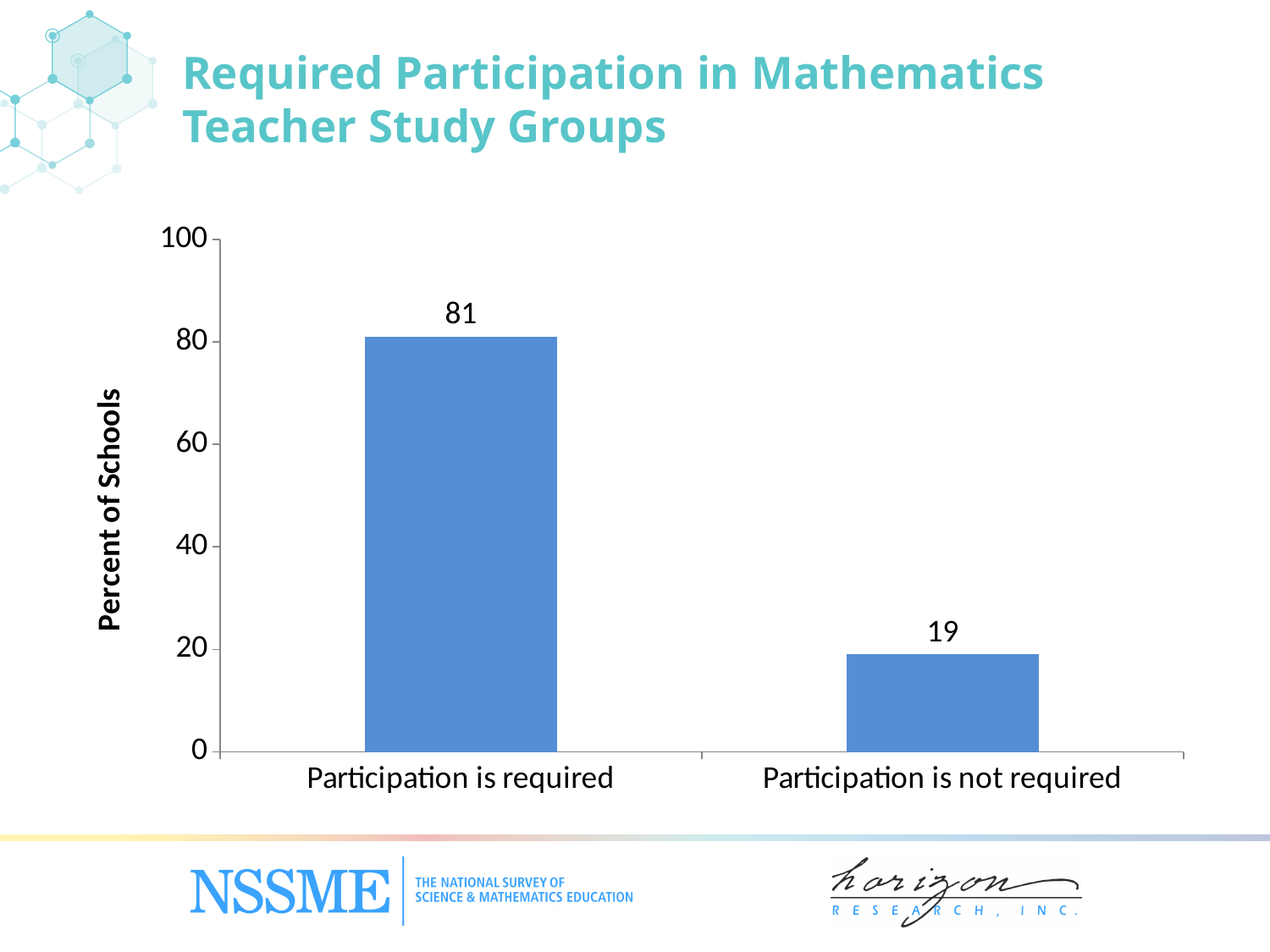
What is the title of the slide? Required Participation in Mathematics Teacher Study Groups What is the difference in percent of schools between 'Participation is required' and 'Participation is not required'? 62 What percent of schools have participation not required in mathematics teacher study groups? 19 What percent of schools have participation required in mathematics teacher study groups? 81 Is the value for 'Participation is required' larger or smaller than the value for 'Participation is not required'? larger How many categories are shown on the x axis? 2 What is the label of the vertical axis? Percent of Schools Which category has the higher percent of schools? Participation is required Which category has the lower percent of schools? Participation is not required What kind of chart is shown on the slide? bar chart Is the value for 'Participation is not required' greater or less than 20? less Is the value for 'Participation is required' greater or less than 80? greater